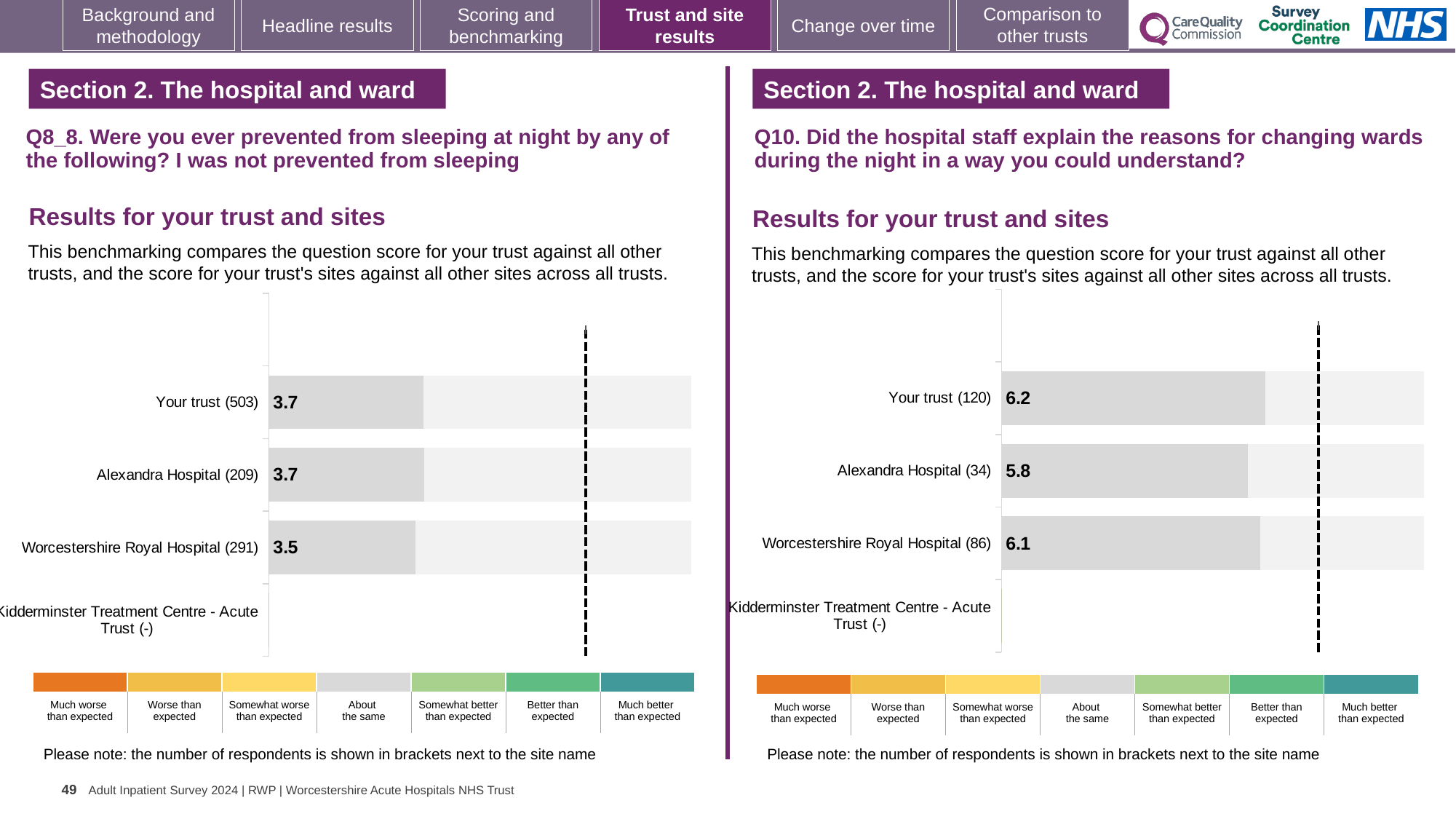
In the Q10 chart on the right, which site has the lowest score? Alexandra Hospital (34) In the Q10 chart on the right, what is the score for Alexandra Hospital (34)? 5.8 In the Q10 chart on the right, what is the score for Your trust (120)? 6.2 In the Q8_8 chart on the left, what is the score for Your trust (503)? 3.7 In the Q10 chart on the right, which is larger: the score for Worcestershire Royal Hospital (86) or Alexandra Hospital (34)? Worcestershire Royal Hospital (86) In the Q8_8 chart on the left, what is the score for Worcestershire Royal Hospital (291)? 3.5 What kind of chart is used on the left side of the slide for Q8_8? Bar chart In the Q10 chart on the right, what is the difference between the scores for Your trust (120) and Alexandra Hospital (34)? 0.4 In the Q8_8 chart on the left, what is the difference between the scores for Alexandra Hospital (209) and Worcestershire Royal Hospital (291)? 0.2 In the Q10 chart on the right, what is the score for Worcestershire Royal Hospital (86)? 6.1 In the Q8_8 chart on the left, which site has the lowest score? Worcestershire Royal Hospital (291) In the Q8_8 chart on the left, how many respondents are shown in brackets for Alexandra Hospital? 209